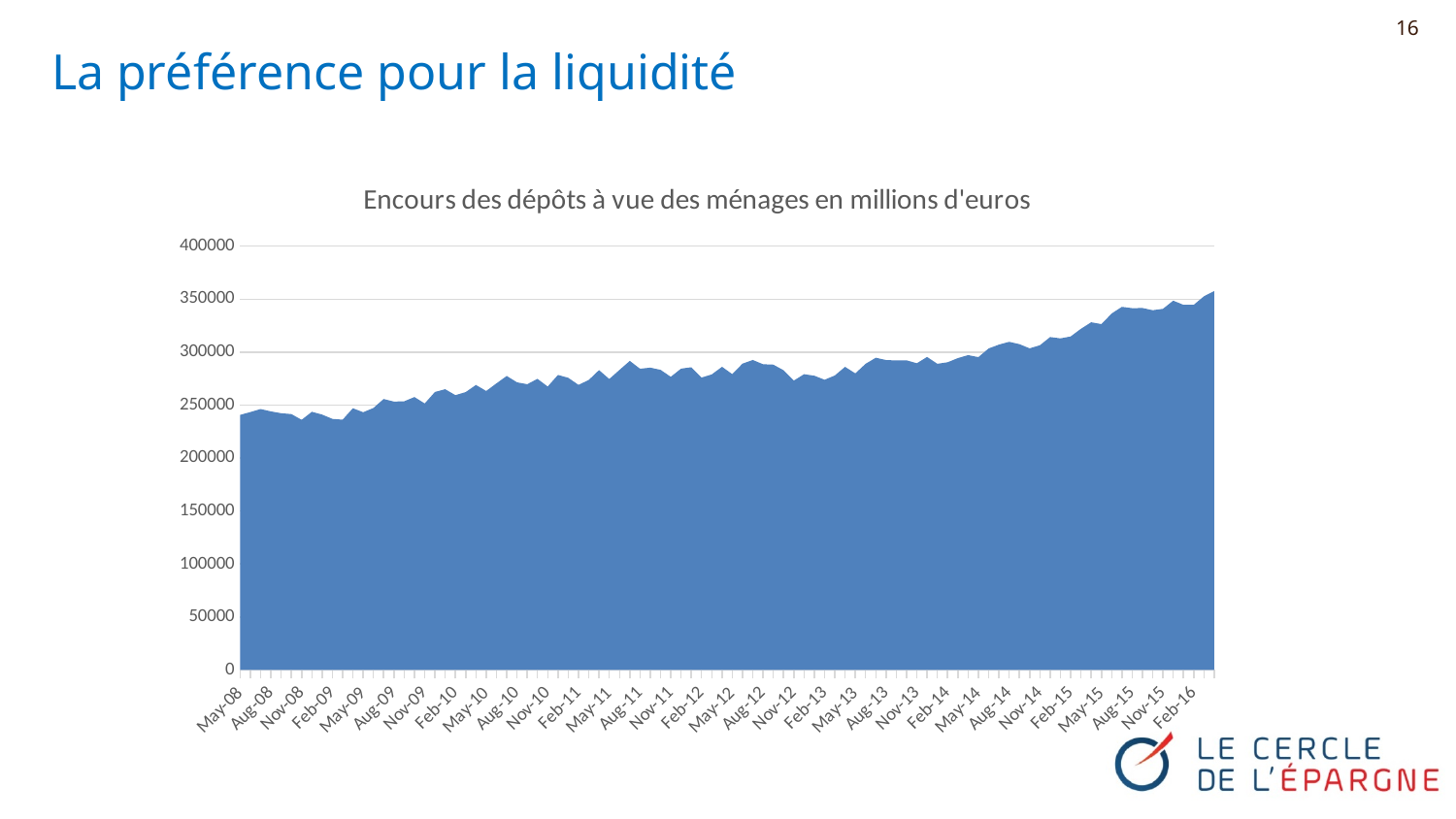
Is the value for Feb-16 greater or less than 300000? greater What is the highest value shown on the y axis? 400000 Is the value for May-08 greater or less than 250000? less Is the value for May-11 greater or less than 250000? greater Which is larger, the value for Feb-16 or the value for May-08? Feb-16 Do the values generally rise or fall from May-08 to Feb-16? rise What is the title of the chart? Encours des dépôts à vue des ménages en millions d'euros What kind of chart is shown on the slide? area chart